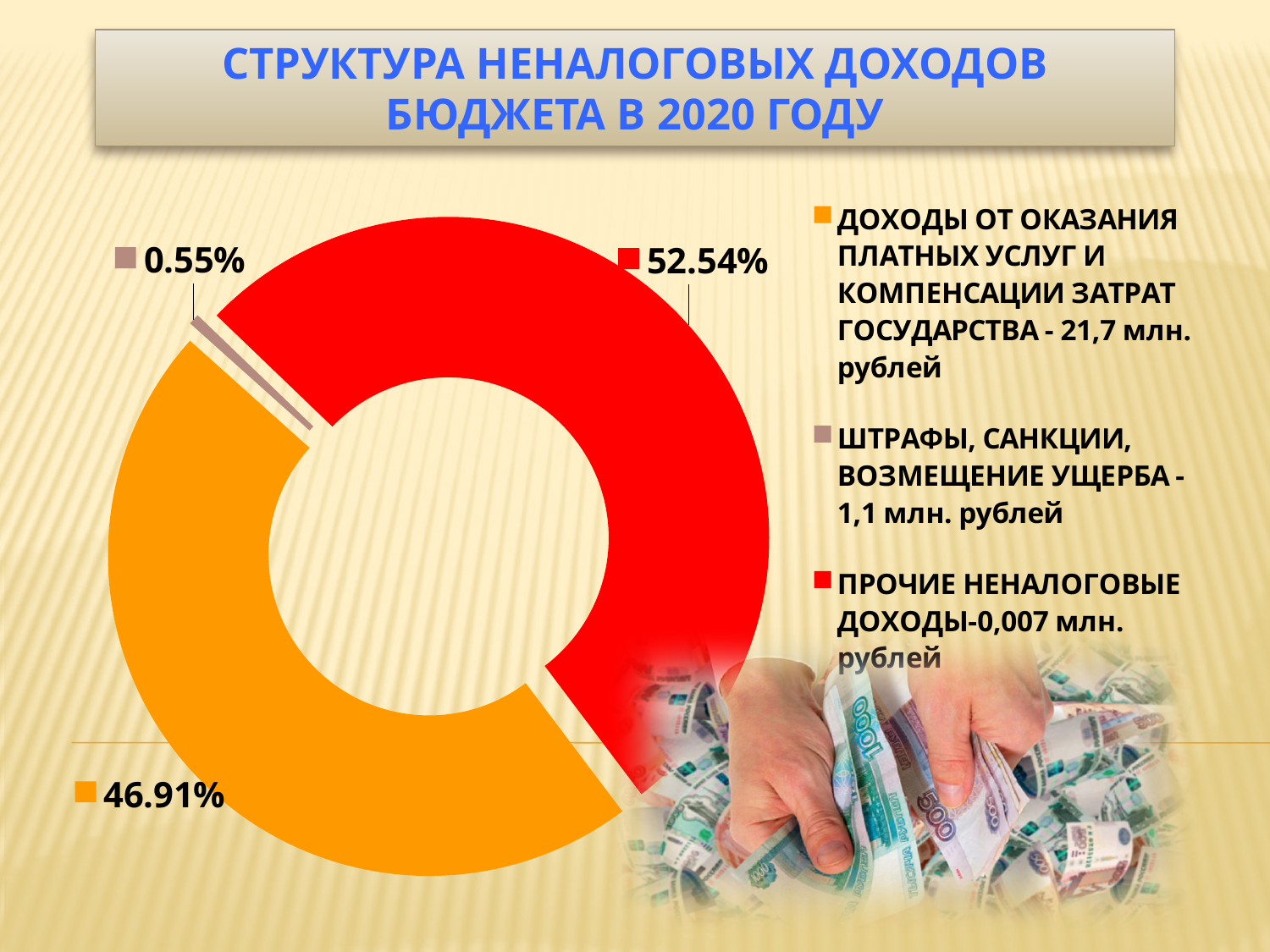
How many slices does the doughnut chart have? 3 What kind of chart is shown on the slide? doughnut (pie) chart What percentage is shown for the red slice (Прочие неналоговые доходы)? 52.54% What is the title of the chart on the slide? СТРУКТУРА НЕНАЛОГОВЫХ ДОХОДОВ БЮДЖЕТА В 2020 ГОДУ What percentage is shown for the orange slice (Доходы от оказания платных услуг и компенсации затрат государства)? 46.91% How many entries does the legend list? 3 Which legend category has the smallest share of the doughnut chart? Штрафы, санкции, возмещение ущерба What is the difference in percentage points between the red slice (52.54%) and the orange slice (46.91%)? 5.63 What percentage is shown for the slice labelled Штрафы, санкции, возмещение ущерба? 0.55% Which legend category has the largest share of the doughnut chart? Прочие неналоговые доходы What colour is the slice representing Доходы от оказания платных услуг и компенсации затрат государства? orange Which slice is larger: the orange slice or the grey slice? the orange slice